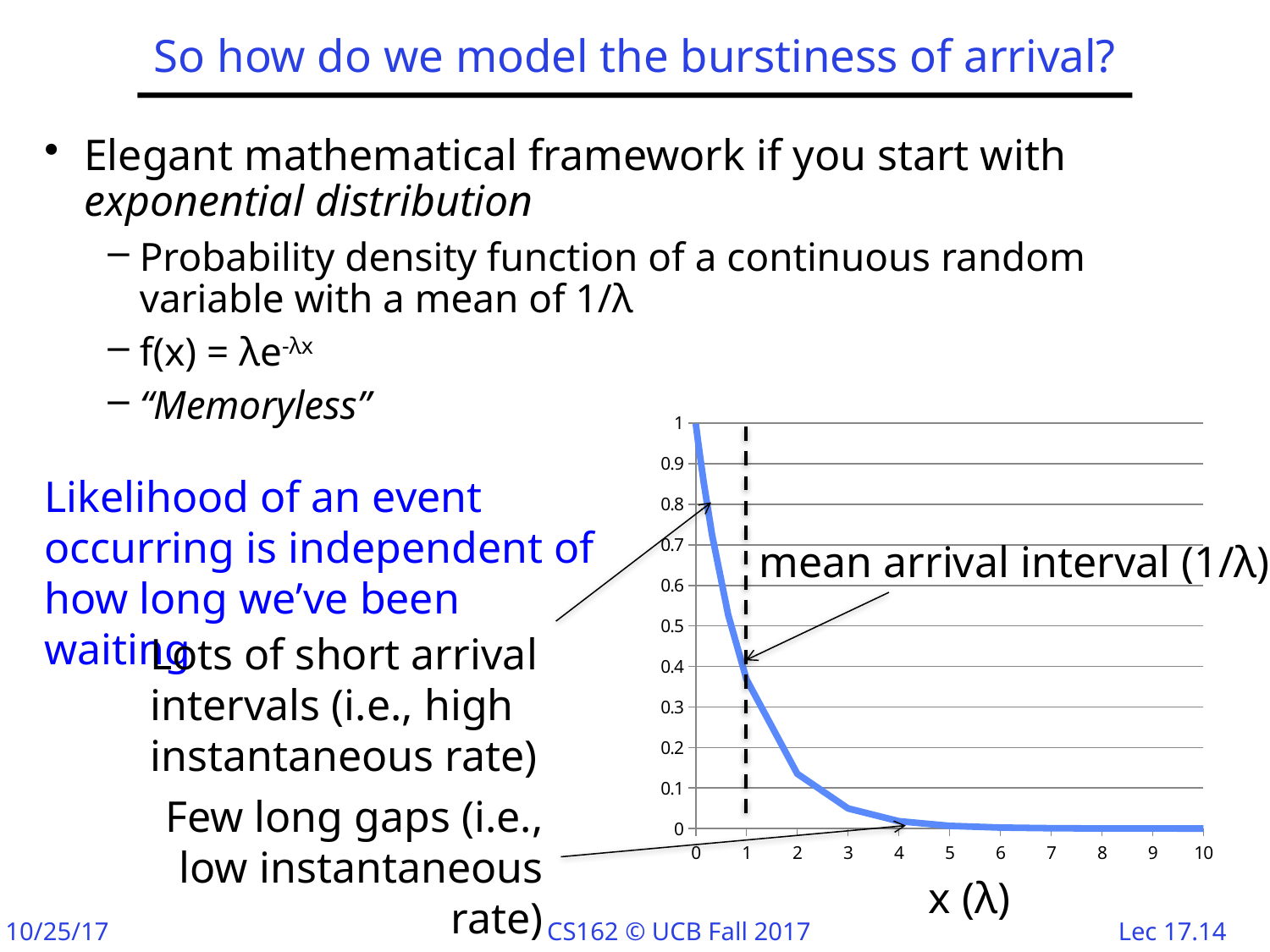
How many tick marks are labelled on the x axis? 11 Is the value of the curve at x = 1 greater or less than 0.5? less Do the plotted values rise or fall as x increases along the x axis? fall What is the label of the x axis of the chart? x (λ) Is the value of the curve at x = 4 greater or less than 0.1? less What kind of chart is shown on the slide? line chart What does the dashed vertical line on the chart mark? mean arrival interval (1/λ) Which is larger, the value of the curve at x = 1 or at x = 5? x = 1 What is the highest value shown on the y axis? 1 Is the value of the curve at x = 1 greater or less than 0.3? greater